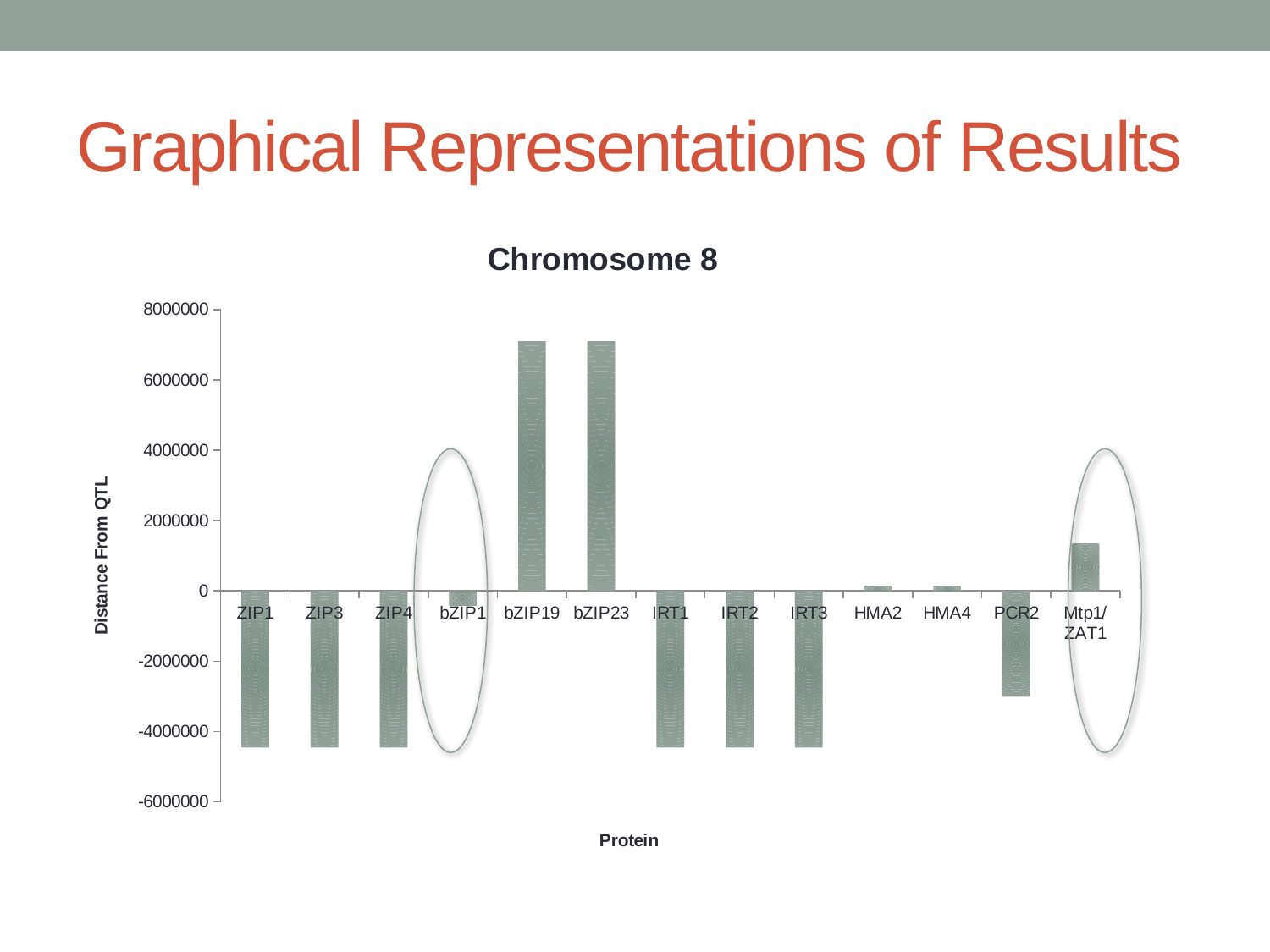
Which has the larger value, Mtp1/ZAT1 or HMA4? Mtp1/ZAT1 What is the label of the vertical axis? Distance From QTL Is the value for HMA2 greater or less than 0? greater How many proteins (categories) are plotted on the x axis? 13 What is the title of the chart? Chromosome 8 Is the value for bZIP19 greater or less than 6000000? greater Is the value for ZIP1 greater or less than -4000000? less How many bars extend below zero? 8 Which has the larger value, bZIP23 or PCR2? bZIP23 What kind of chart is shown on the slide? Bar chart